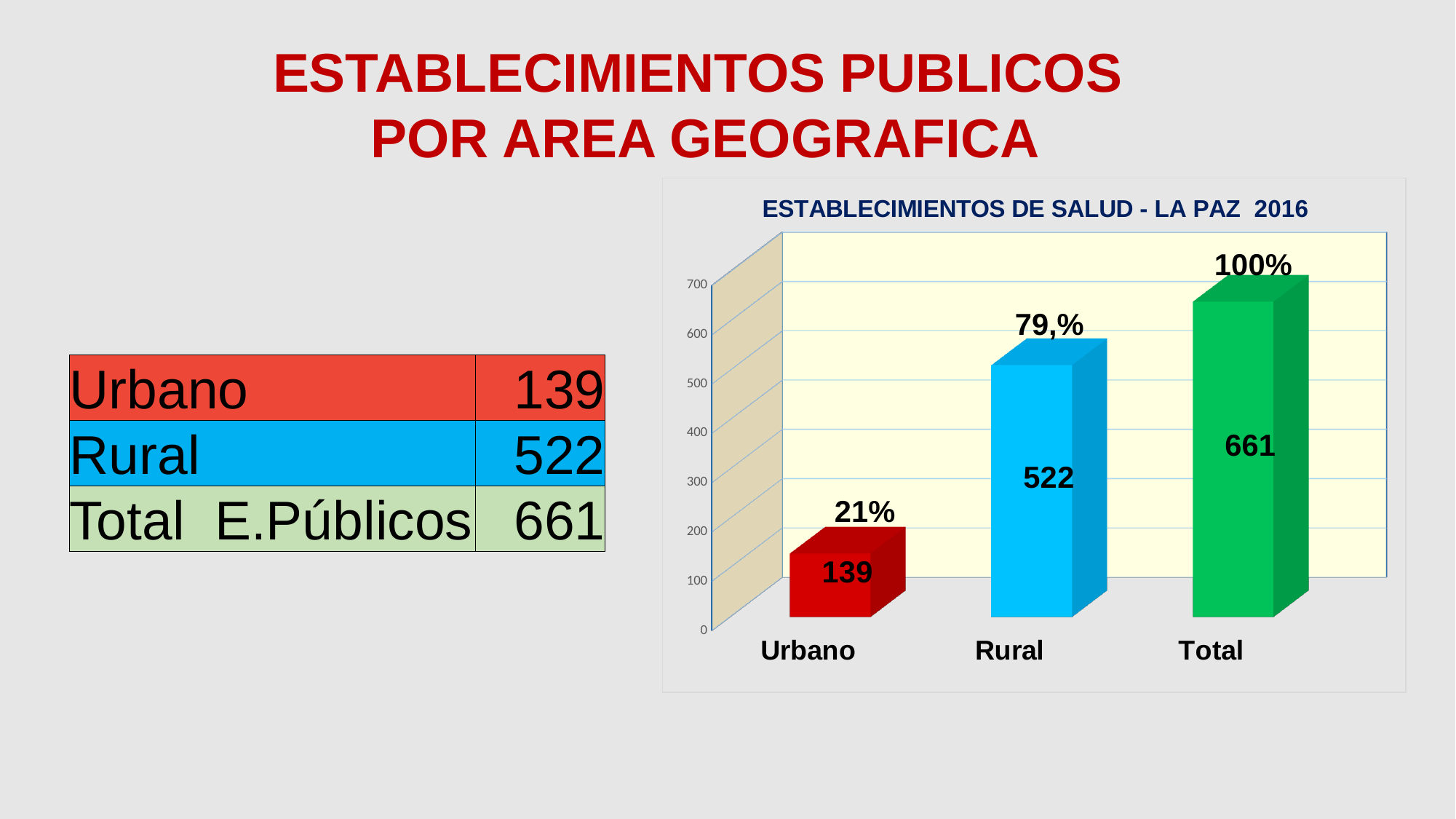
What kind of chart is shown on the slide? bar chart How many categories are shown on the x axis of the chart? 3 What is the difference between the values for Rural and Urbano? 383 Which category has the highest value in the chart? Total What is the value for Urbano in the chart? 139 What percentage label is shown above the Urbano bar? 21% What is the title of the chart? ESTABLECIMIENTOS DE SALUD - LA PAZ 2016 What is the value for Total in the chart? 661 Which is larger, the value for Rural or the value for Urbano? Rural What is the value for Rural in the chart? 522 Is the value for Rural greater or less than 500? greater Which category has the lowest value in the chart? Urbano